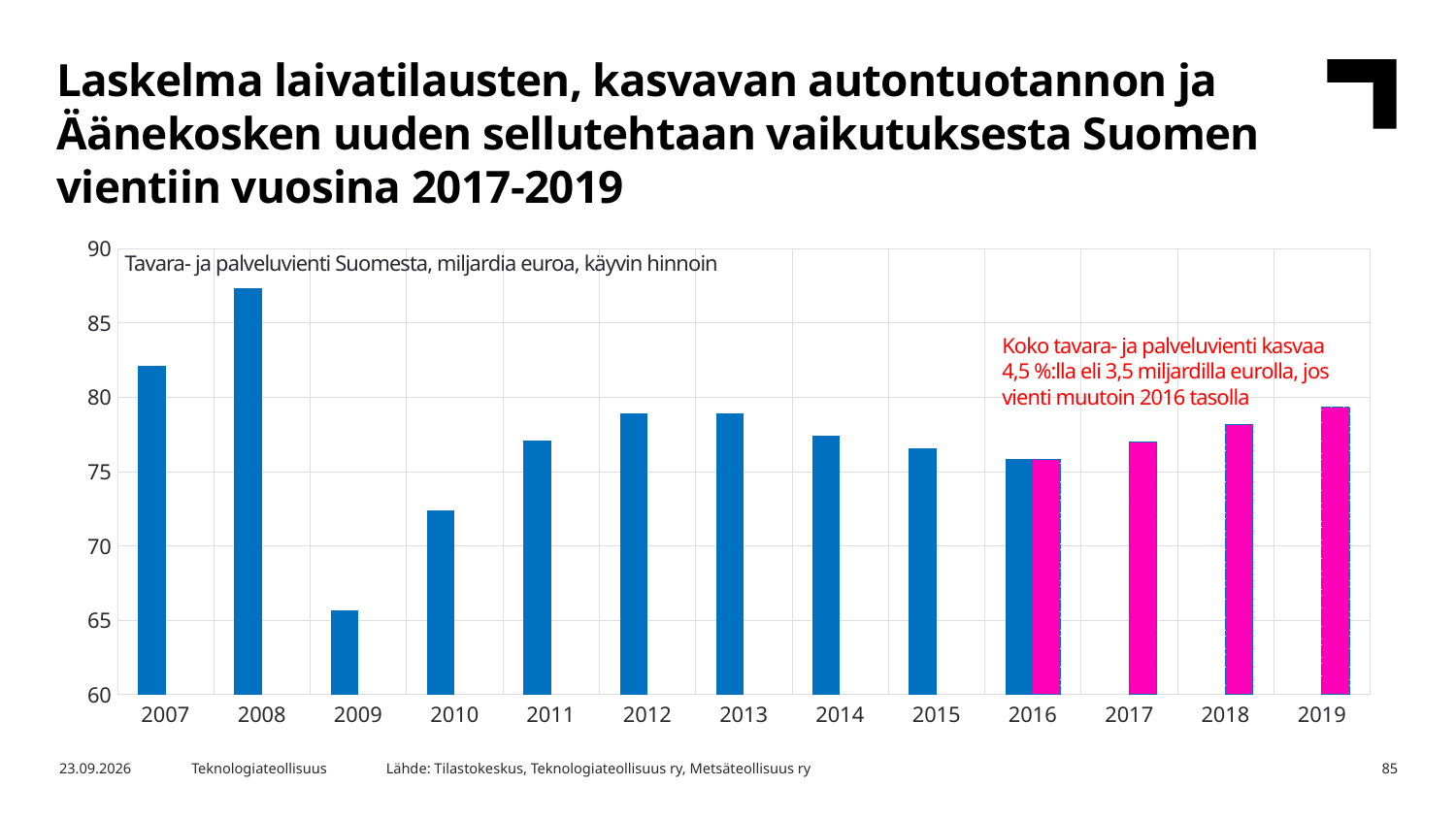
Is the value for 2019 greater or less than 80? less Do the magenta bars rise or fall from 2016 to 2019? Rise Is the value for 2009 greater or less than 70? less Is the value for 2008 greater or less than 85? greater What kind of chart is shown on the slide? Bar chart How many years are shown on the x axis of the chart? 13 Which year has the larger value, 2007 or 2016? 2007 Which year has the larger value, 2010 or 2011? 2011 What is the subtitle text shown inside the chart area? Tavara- ja palveluvienti Suomesta, miljardia euroa, käyvin hinnoin Which year has the highest export value in the chart? 2008 Which year has the lowest export value in the chart? 2009